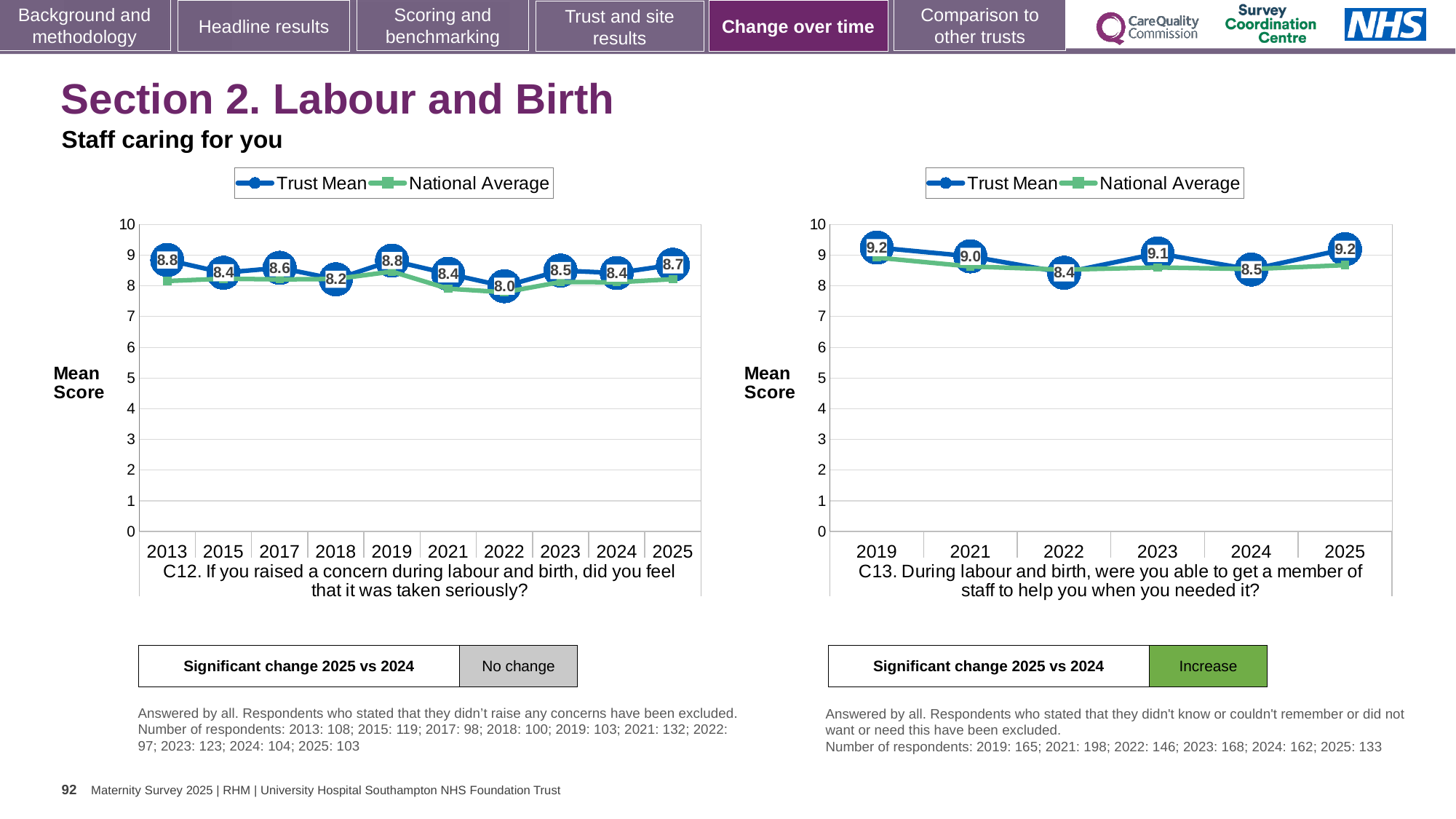
In the C13 chart on the right, which year has the lowest Trust Mean? 2022 In the C12 chart on the left, what is the Trust Mean for 2025? 8.7 In the C12 chart on the left, which is larger: the Trust Mean for 2018 or for 2019? 2019 In the C13 chart on the right, what is the Trust Mean for 2024? 8.5 In the C13 chart on the right, what is the Trust Mean for 2021? 9.0 How many years are plotted on the x axis of the C12 chart on the left? 10 In the C13 chart on the right, is the National Average for 2019 greater or less than 8? greater In the C12 chart on the left, which year has the lowest Trust Mean? 2022 In the C13 chart on the right, what is the difference between the Trust Mean for 2025 and 2024? 0.7 How many series does the legend of the C13 chart on the right list? 2 In the C12 chart on the left, what is the Trust Mean for 2022? 8.0 What kind of chart is the C12 chart on the left? Line chart